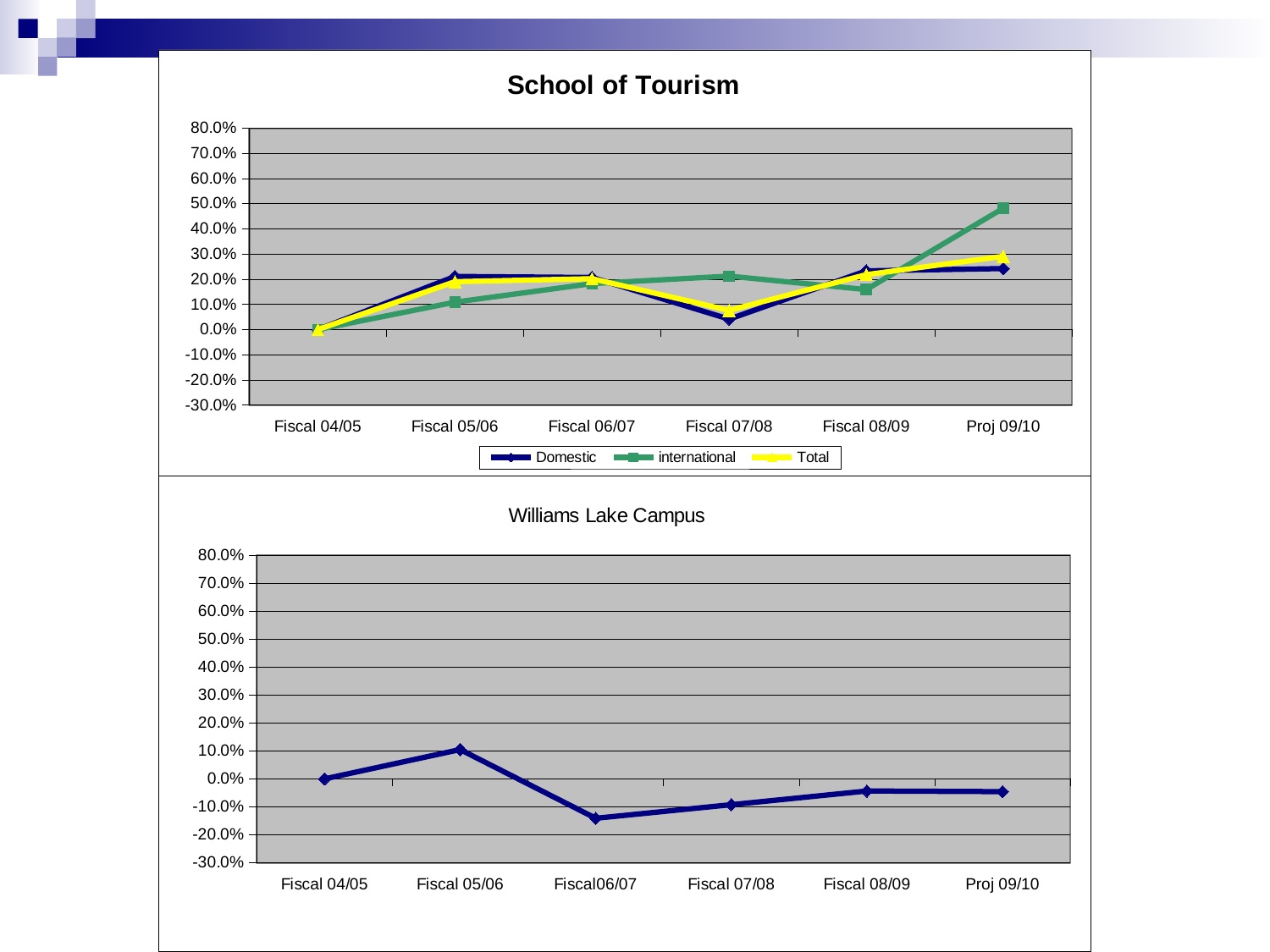
In the Williams Lake Campus chart, which fiscal period has the highest value? Fiscal 05/06 In the School of Tourism chart, is the international value at Proj 09/10 greater or less than 40.0%? greater How many series does the legend of the School of Tourism chart list? 3 How many fiscal periods are shown on the x axis of the Williams Lake Campus chart? 6 In the Williams Lake Campus chart, is the value for Fiscal06/07 greater or less than -10.0%? less In the School of Tourism chart, which is larger at Fiscal 07/08: the international value or the Domestic value? international In the School of Tourism chart, which series has the highest value at Proj 09/10? international In the Williams Lake Campus chart, does the value rise or fall from Fiscal 05/06 to Fiscal06/07? fall What type of chart is the School of Tourism chart? line chart In the Williams Lake Campus chart, which fiscal period has the lowest value? Fiscal06/07 In the School of Tourism chart, what is the Domestic value at Fiscal 04/05? 0.0% In the School of Tourism chart, is the Domestic value at Fiscal 05/06 greater or less than 10.0%? greater